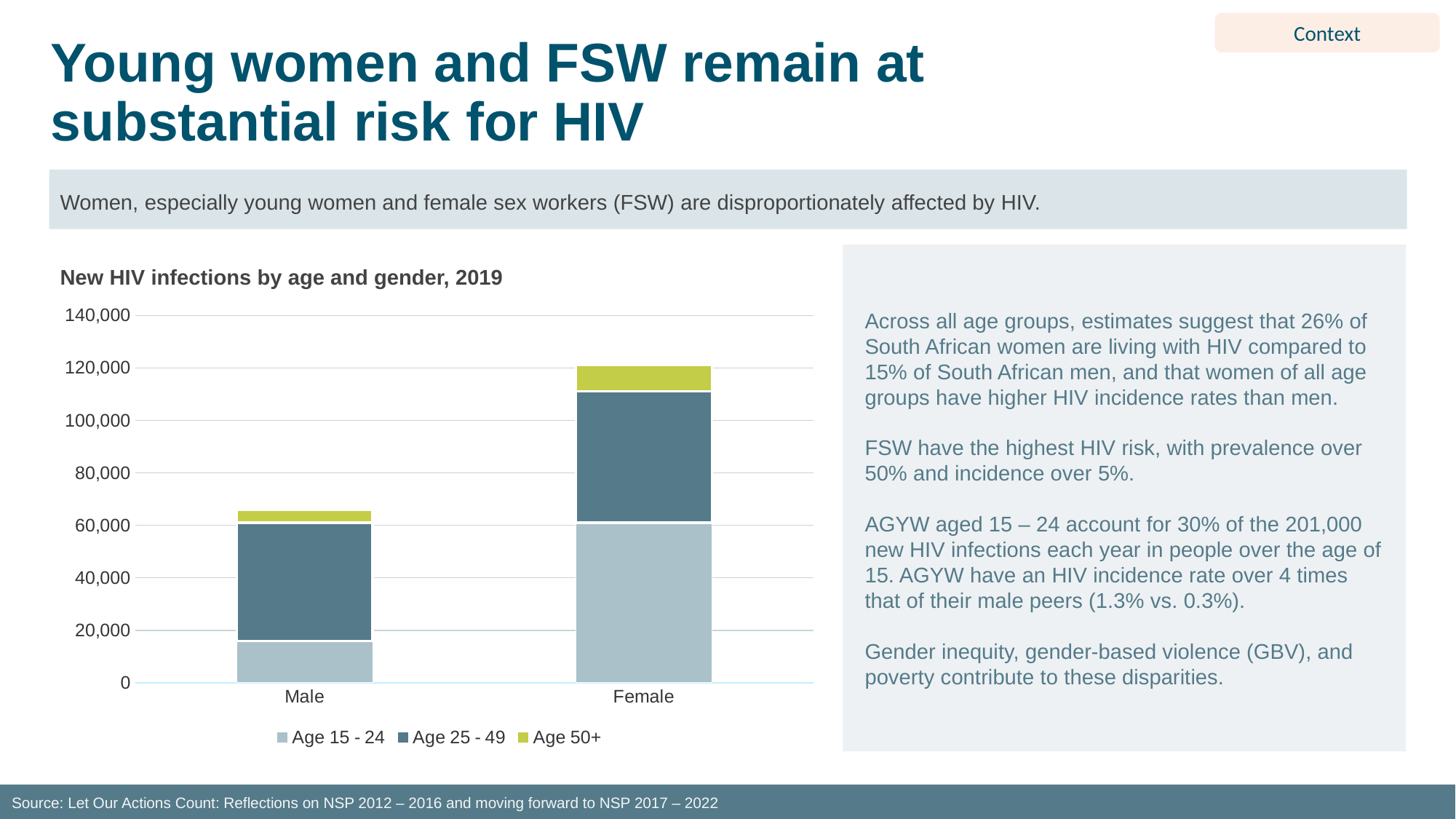
Is the total height of the Male bar greater or less than 80,000? less Which age groups are listed in the chart legend? Age 15 - 24, Age 25 - 49, Age 50+ How many series does the chart legend list? 3 Is the Age 15 - 24 segment for Male greater or less than 20,000? less Which category has the taller stacked bar, Male or Female? Female Is the total height of the Female bar greater or less than 100,000? greater How many categories are shown on the x axis of the chart? 2 What is the title of the chart? New HIV infections by age and gender, 2019 What kind of chart is shown on the slide? Stacked bar chart Which is larger, the Age 15 - 24 segment for Male or for Female? Female Which is larger, the Age 50+ segment for Male or for Female? Female